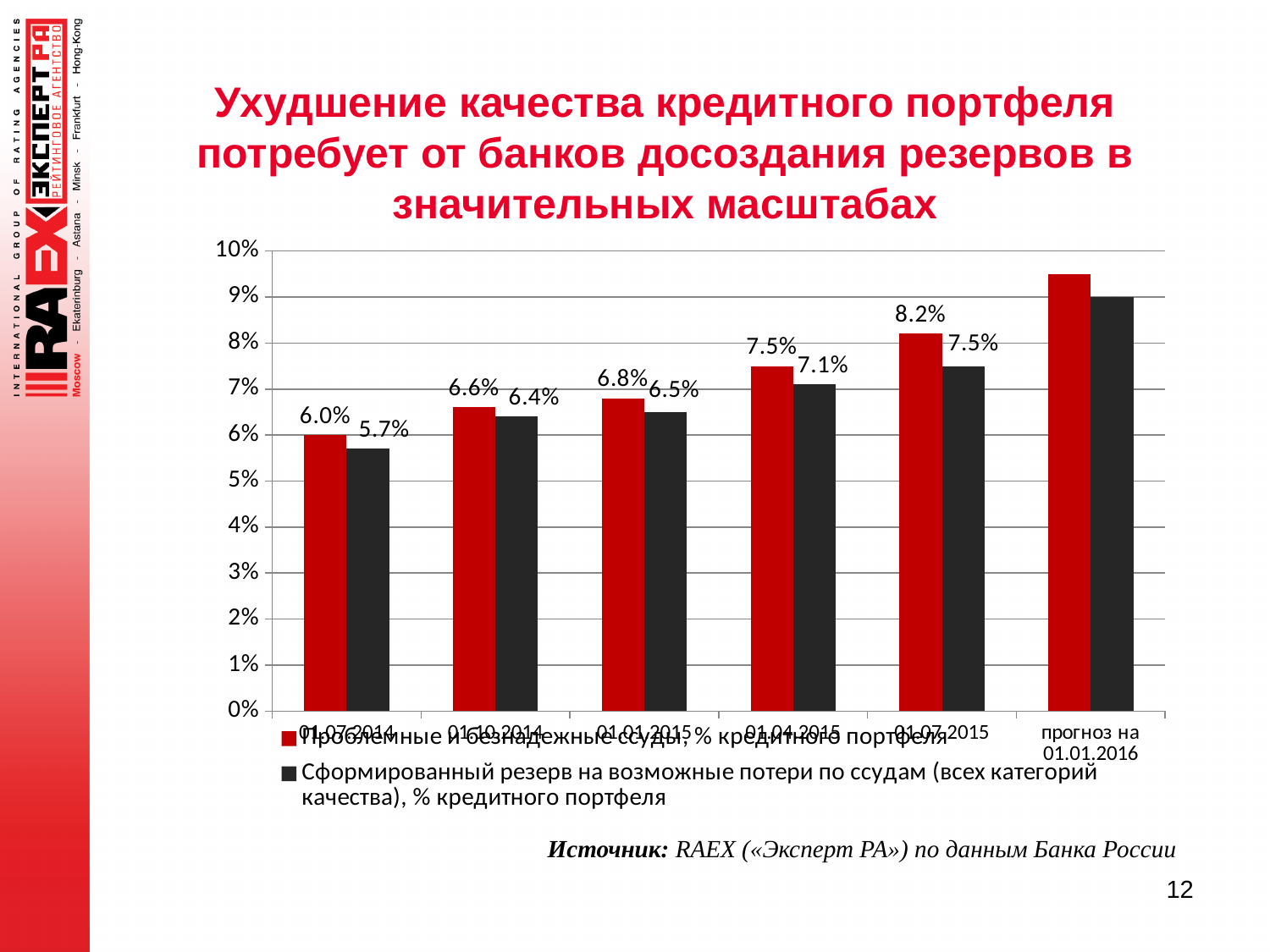
What kind of chart is shown on the slide? bar chart What is the value of 'Проблемные и безнадежные ссуды' for 01.07.2015? 8.2% What is the difference between 'Проблемные и безнадежные ссуды' and 'Сформированный резерв' for 01.07.2015? 0.7 percentage points How many periods (categories) are shown on the x axis? 6 Is the value of 'Проблемные и безнадежные ссуды' for 'прогноз на 01.01.2016' greater or less than 9%? greater What is the value of 'Проблемные и безнадежные ссуды, % кредитного портфеля' for 01.07.2014? 6.0% What is the value of 'Сформированный резерв на возможные потери по ссудам' for 01.04.2015? 7.1% How many series does the legend list? 2 What is the value of 'Сформированный резерв на возможные потери по ссудам' for 01.10.2014? 6.4% Which period has the lowest value for 'Сформированный резерв на возможные потери по ссудам'? 01.07.2014 For 01.01.2015, which series has the larger value: 'Проблемные и безнадежные ссуды' or 'Сформированный резерв'? Проблемные и безнадежные ссуды Do the values of 'Проблемные и безнадежные ссуды' rise or fall from 01.07.2014 to the forecast for 01.01.2016? rise